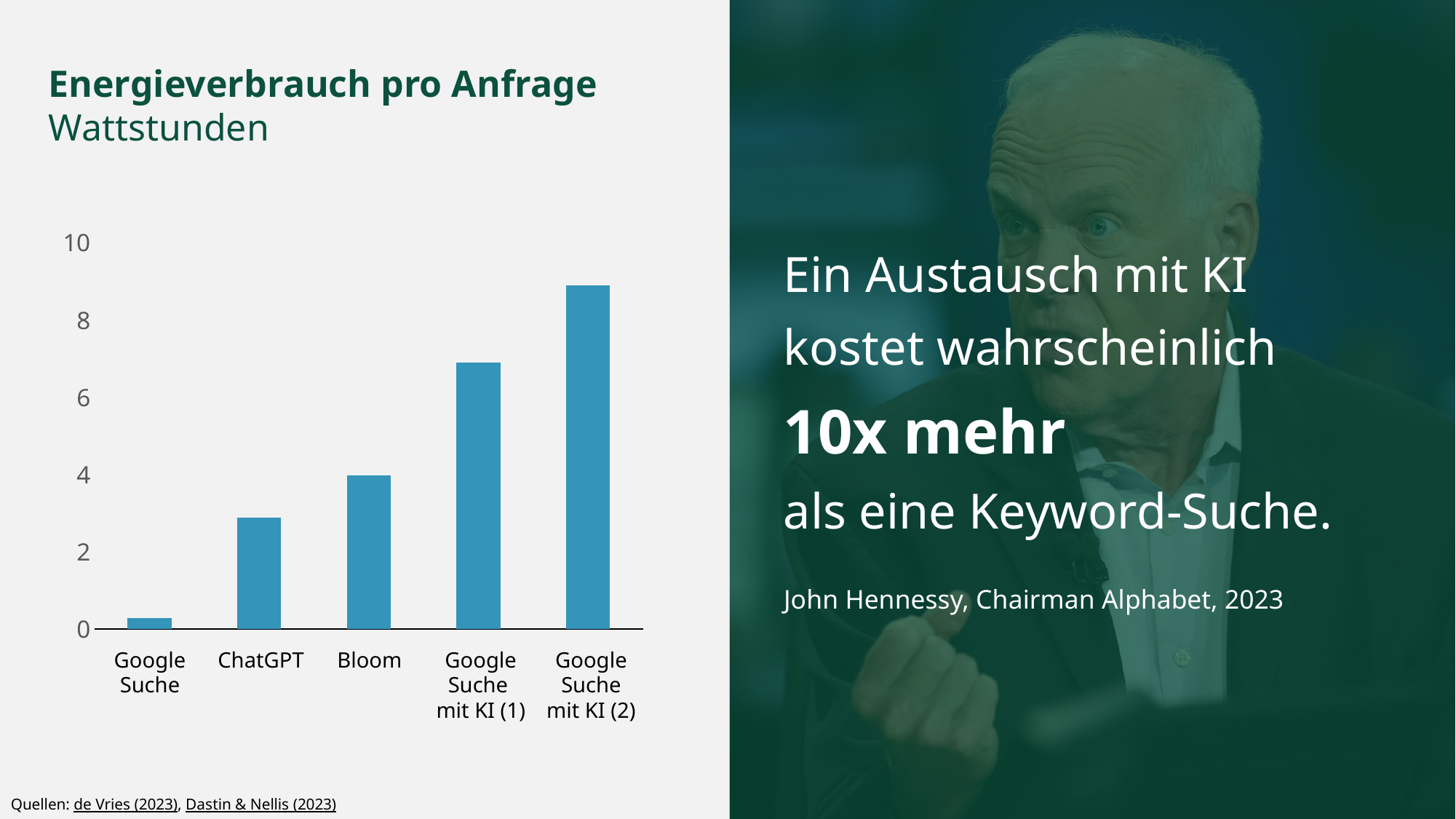
Do the values rise or fall from left to right along the x axis? rise How many categories are shown on the x axis of the chart? 5 Which category has the highest energy consumption per query? Google Suche mit KI (2) Is the value for Google Suche greater or less than 2? less In what unit are the chart values given? Wattstunden Is the value for Google Suche mit KI (2) greater or less than 10? less Is the value for Google Suche mit KI (1) greater or less than 6? greater Which has a larger value, Bloom or ChatGPT? Bloom What is the title of the chart? Energieverbrauch pro Anfrage What kind of chart is shown on the slide? bar chart Which category has the lowest energy consumption per query? Google Suche